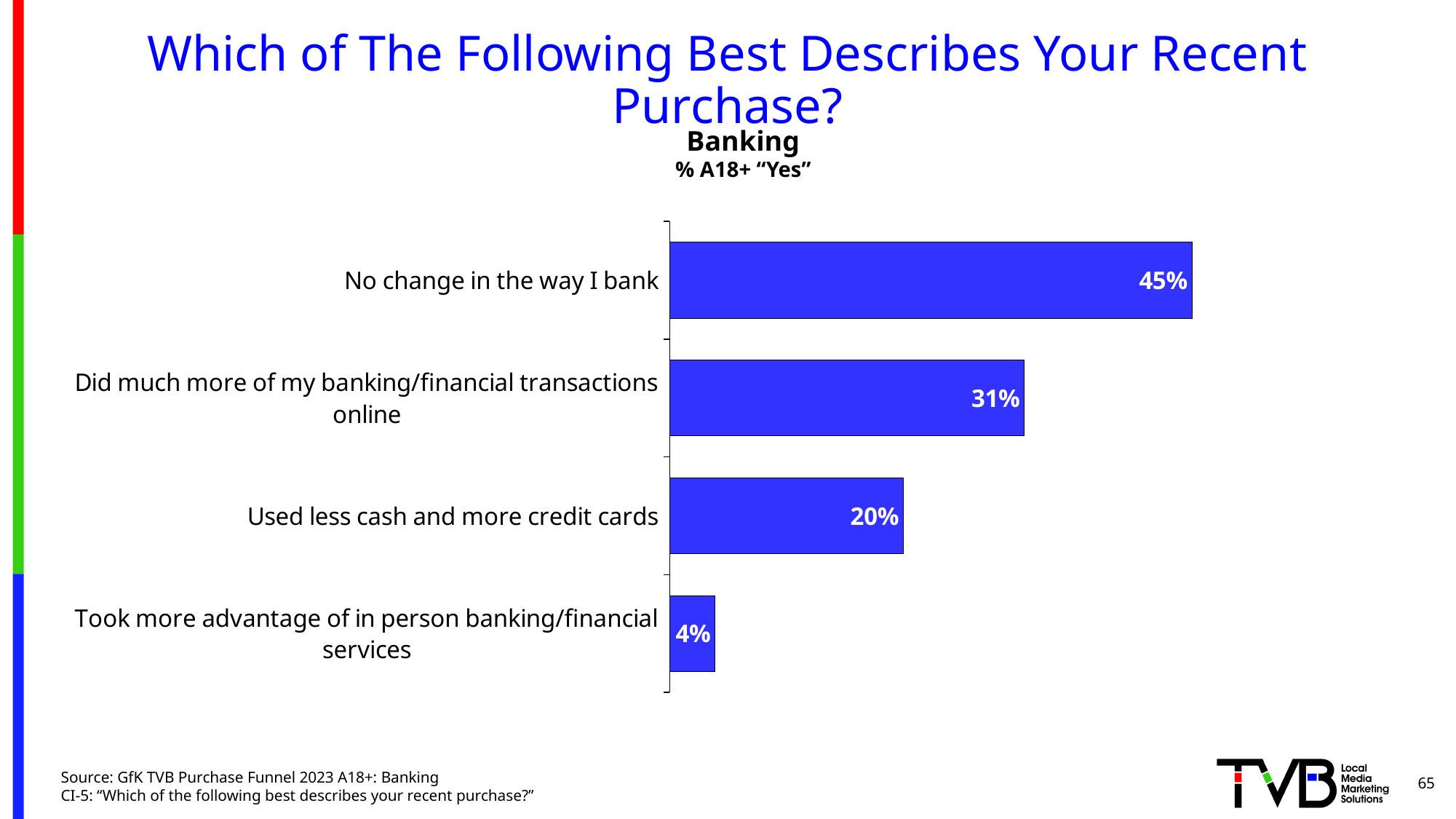
What is the difference between "Used less cash and more credit cards" and "Took more advantage of in person banking/financial services"? 16% What kind of chart is shown on the slide? Bar chart What percentage is shown for "Used less cash and more credit cards"? 20% Which is larger: "Did much more of my banking/financial transactions online" or "Used less cash and more credit cards"? Did much more of my banking/financial transactions online What percentage of A18+ said "No change in the way I bank"? 45% What is the title of the chart? Banking What is the value for "Took more advantage of in person banking/financial services"? 4% How many categories are shown in the chart? 4 Which category has the lowest value? Took more advantage of in person banking/financial services What is the value for "Did much more of my banking/financial transactions online"? 31% What is the difference between "No change in the way I bank" and "Did much more of my banking/financial transactions online"? 14% Which category has the highest value? No change in the way I bank